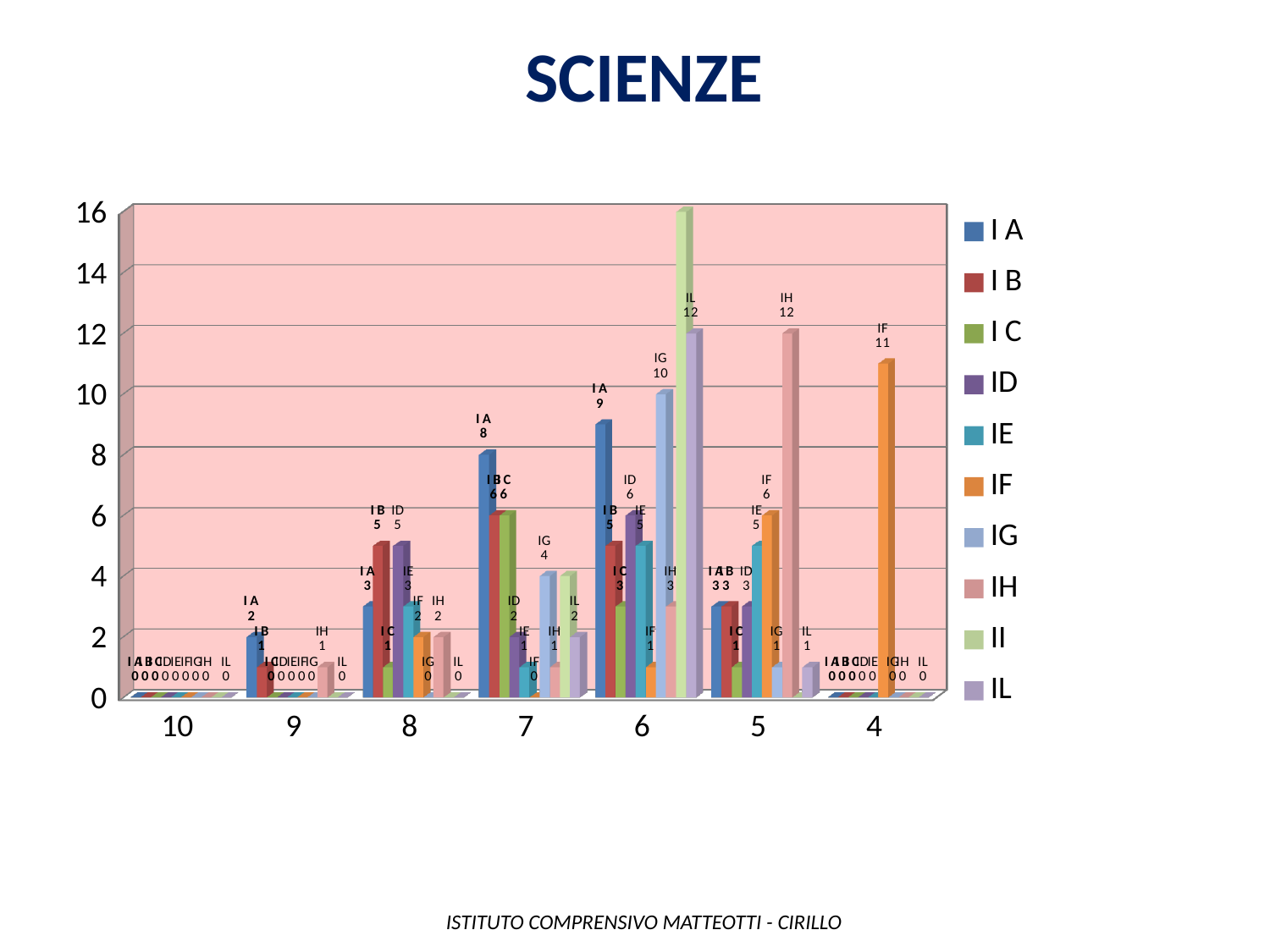
What is the value for I A in category 7? 8 Which series has the highest value in category 5? IH What is the value for IG in category 6? 10 What is the difference between the IG value in category 6 and the IG value in category 7? 6 What is the value for IL in category 6? 12 In category 5, which is larger: the value for IF or the value for IE? IF How many categories are shown along the x axis? 7 How many series does the legend list? 10 Is the value for II in category 6 greater or less than 14? greater What is the value for IF in category 4? 11 What is the value for IH in category 5? 12 What kind of chart is shown on the slide? bar chart